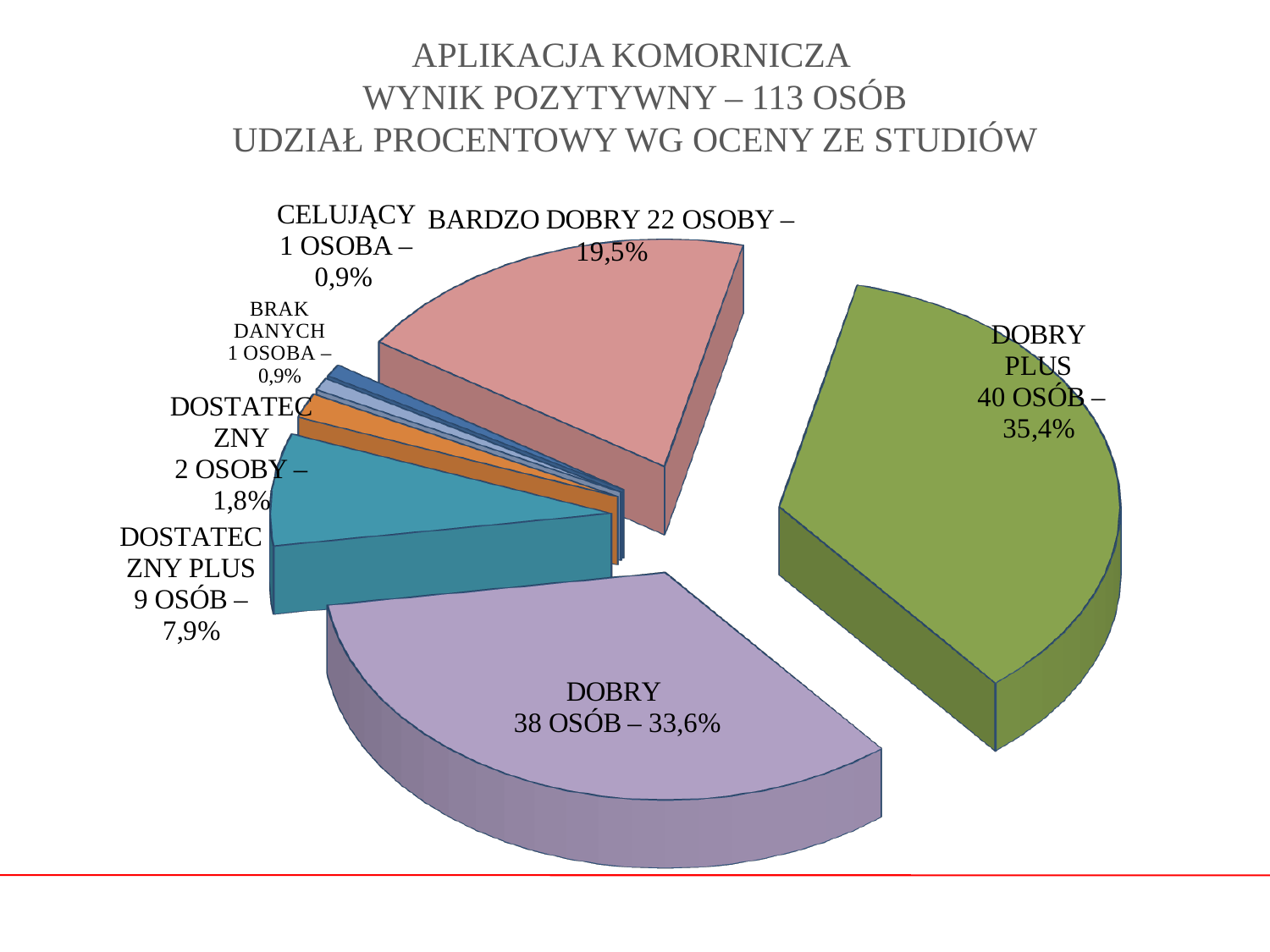
What percentage share does the DOBRY PLUS slice have? 35,4% How many people are in the DOSTATECZNY PLUS category? 9 What percentage share does the CELUJĄCY slice have? 0,9% What kind of chart is shown on the slide? pie chart Which category has the largest share of the pie? DOBRY PLUS How many slices does the pie chart have? 7 What percentage share does the BARDZO DOBRY slice have? 19,5% Which category has the larger share, DOBRY or BARDZO DOBRY? DOBRY What is the total number of people with a positive result stated in the chart title? 113 How many people (osób) are in the DOBRY category? 38 What is the difference in number of people between DOBRY PLUS and DOBRY? 2 What percentage share does the DOSTATECZNY slice have? 1,8%